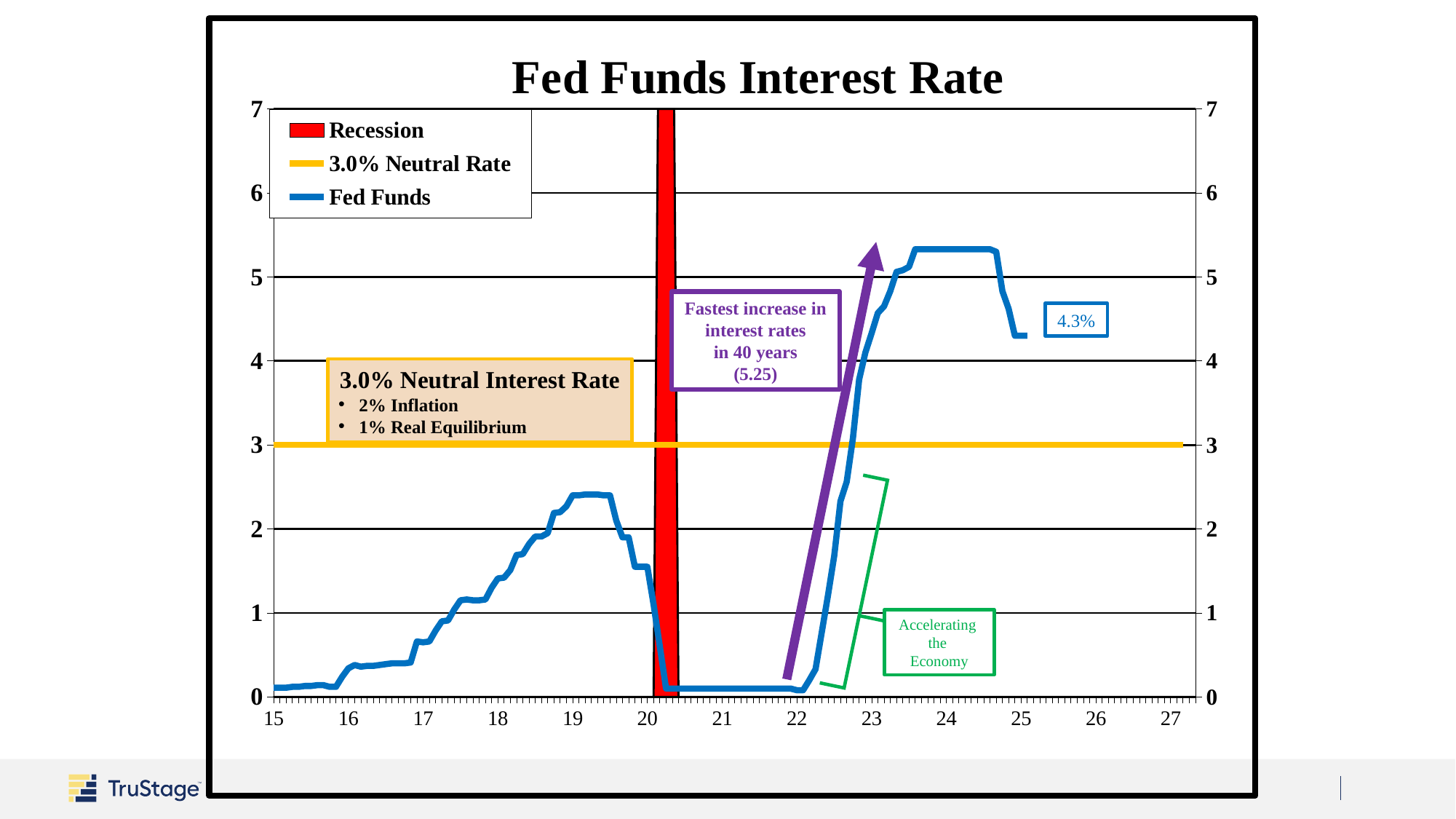
Does the Fed Funds line rise or fall between 22 and 23 on the x axis? rise What value is labelled at the end of the Fed Funds line, near 25 on the x axis? 4.3% What kind of chart is shown on the slide? line chart Is the Fed Funds value at 19 on the x axis greater or less than 2? greater What is the title of the chart? Fed Funds Interest Rate Around which x-axis year label does the Fed Funds line reach its highest level? 24 Is the Fed Funds value at 21 on the x axis greater or less than 1? less What colour is used for the Recession entry in the legend? red How many entries does the chart's legend list? 3 Is the Fed Funds value at 24 on the x axis greater or less than 5? greater Which is higher on the Fed Funds line: the peak around 19 or the peak around 24? the peak around 24 At what rate is the neutral rate line drawn, according to the legend? 3.0%